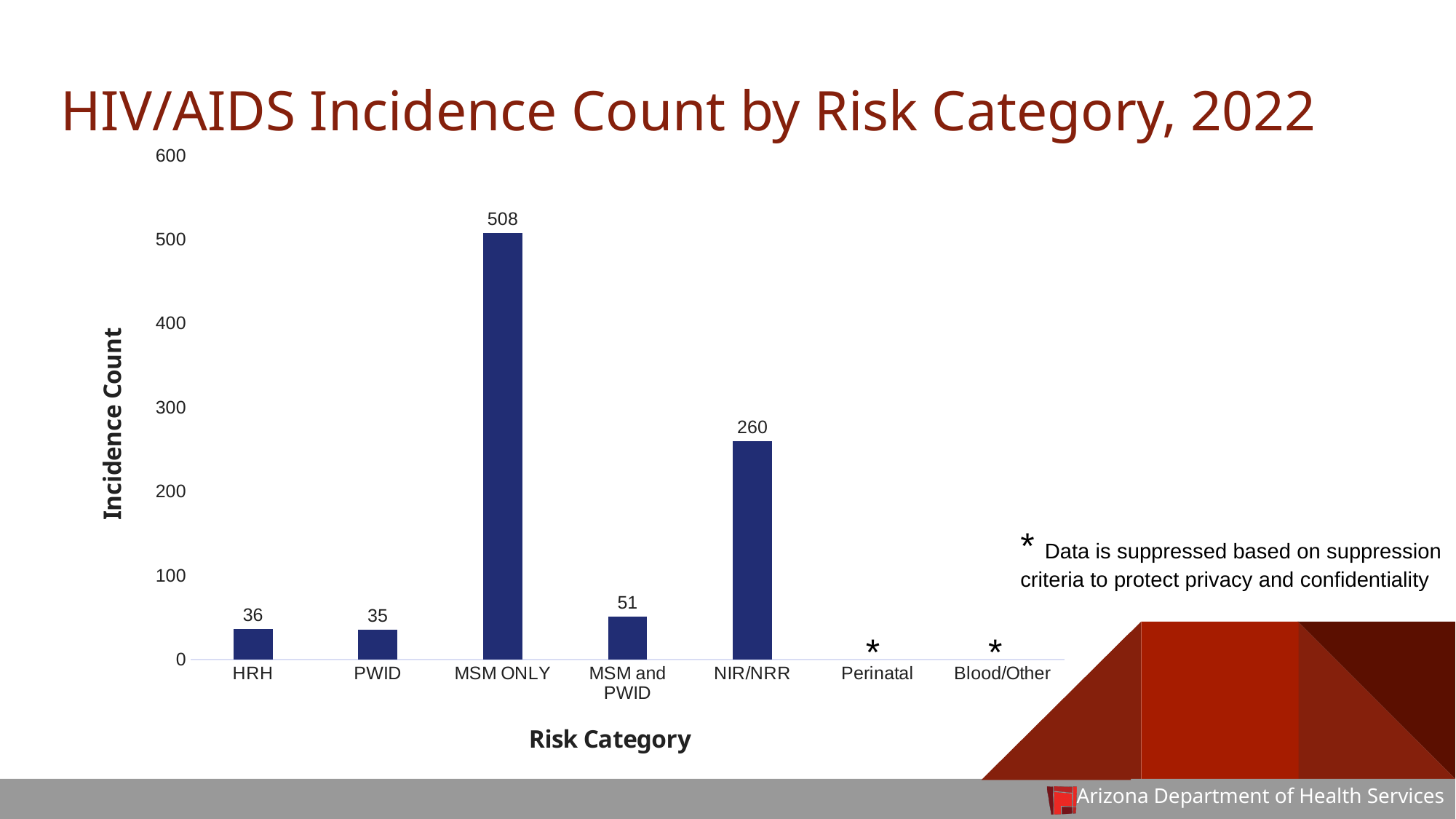
Is the incidence count for NIR/NRR greater or less than 300? less What is the incidence count for NIR/NRR? 260 Among the categories with a printed value, which has the lowest incidence count? PWID What is the incidence count for MSM and PWID? 51 What is the incidence count for HRH? 36 Which risk categories are marked with an asterisk indicating suppressed data? Perinatal and Blood/Other What is the incidence count for MSM ONLY? 508 Which has a larger incidence count, MSM and PWID or HRH? MSM and PWID What kind of chart is shown on the slide? Bar chart How many risk categories are shown on the x axis? 7 What is the difference between the incidence counts for MSM ONLY and NIR/NRR? 248 Which risk category has the highest incidence count? MSM ONLY